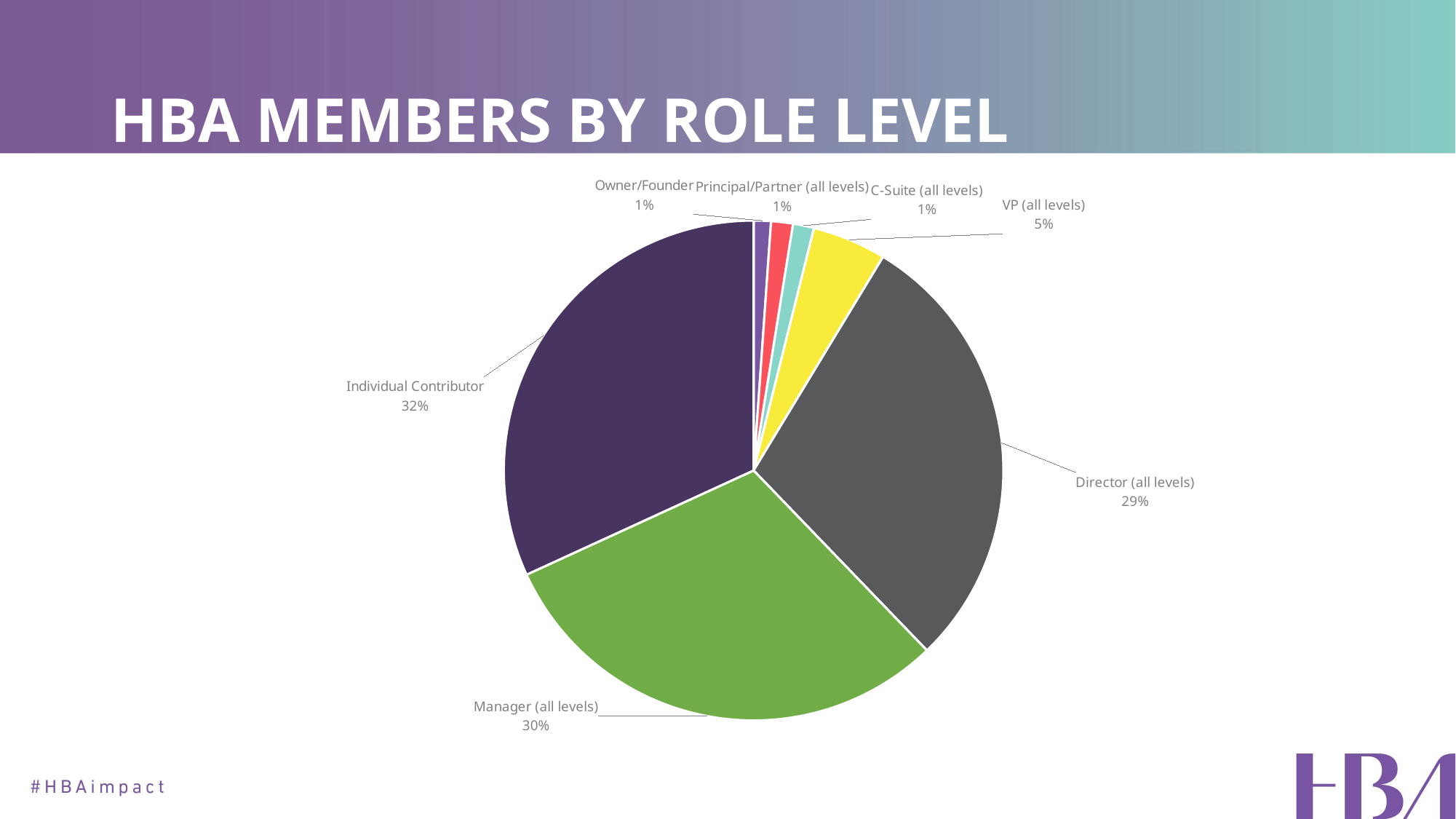
What percentage of HBA members are VP (all levels)? 5% Which role level has the largest share of HBA members? Individual Contributor What is the title of the chart on the slide? HBA MEMBERS BY ROLE LEVEL Which is larger, the share for Manager (all levels) or Director (all levels)? Manager (all levels) What is the difference in percentage points between VP (all levels) and C-Suite (all levels)? 4 What percentage of HBA members are at the Director (all levels) role level? 29% What is the difference in percentage points between Individual Contributor and Director (all levels)? 3 What share of the pie is Manager (all levels)? 30% What share of HBA members are Individual Contributors? 32% How many role level categories are shown in the pie chart? 7 What share of HBA members are Owner/Founder? 1% What type of chart is shown on the slide? Pie chart